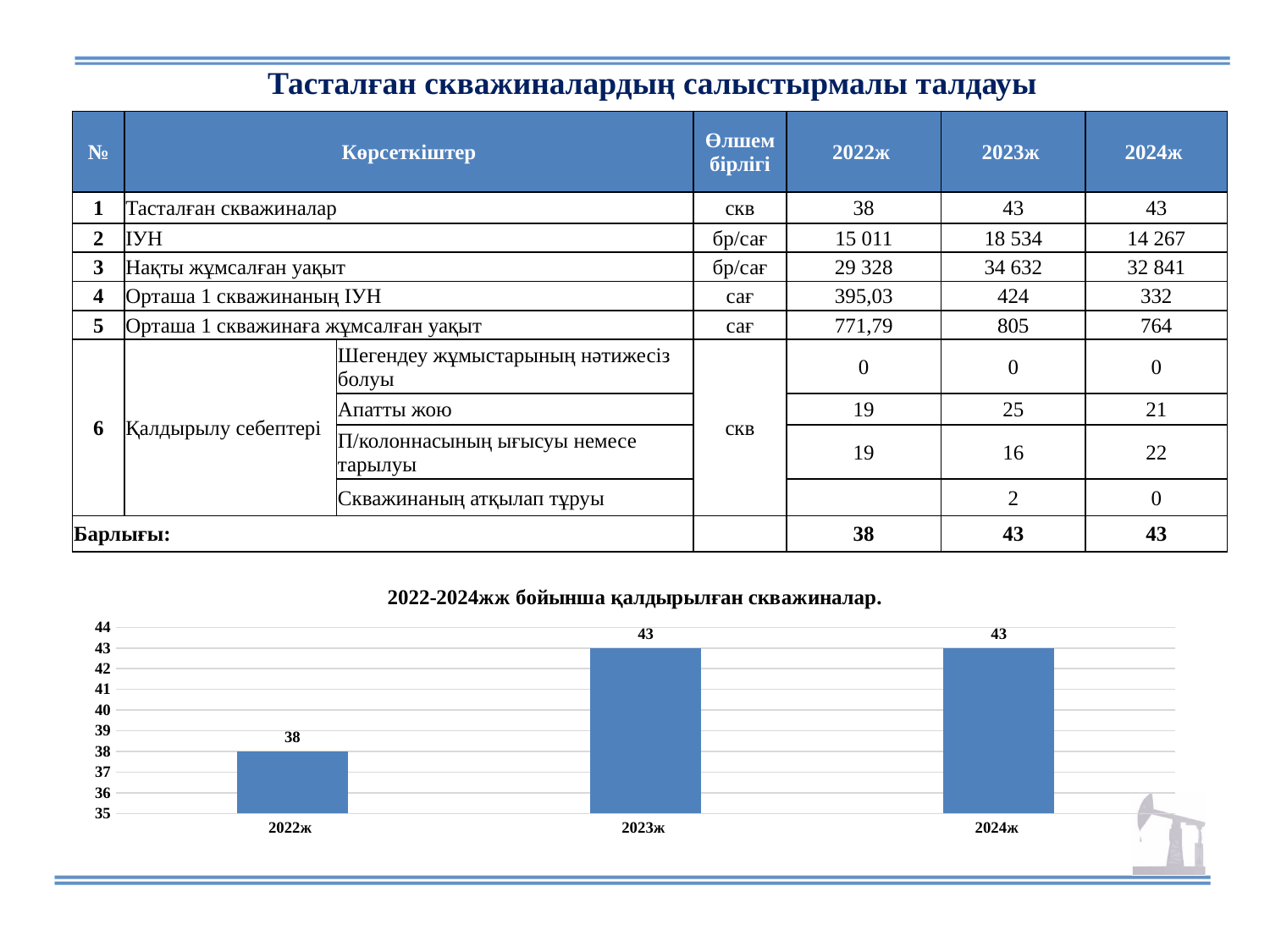
Which is larger in the chart, the value for 2022ж or the value for 2024ж? 2024ж What is the title of the chart? 2022-2024жж бойынша қалдырылған скважиналар. What is the value for 2022ж in the chart? 38 What is the difference between the values for 2023ж and 2022ж in the chart? 5 Is the value for 2023ж in the chart greater or less than 40? greater Is the value for 2022ж in the chart greater or less than 40? less Which year has the lowest value in the chart? 2022ж What is the value for 2023ж in the chart? 43 How many years are shown on the x axis of the chart? 3 What is the value for 2024ж in the chart? 43 What kind of chart is shown on the slide? bar chart Does the value rise or fall from 2022ж to 2023ж in the chart? rise